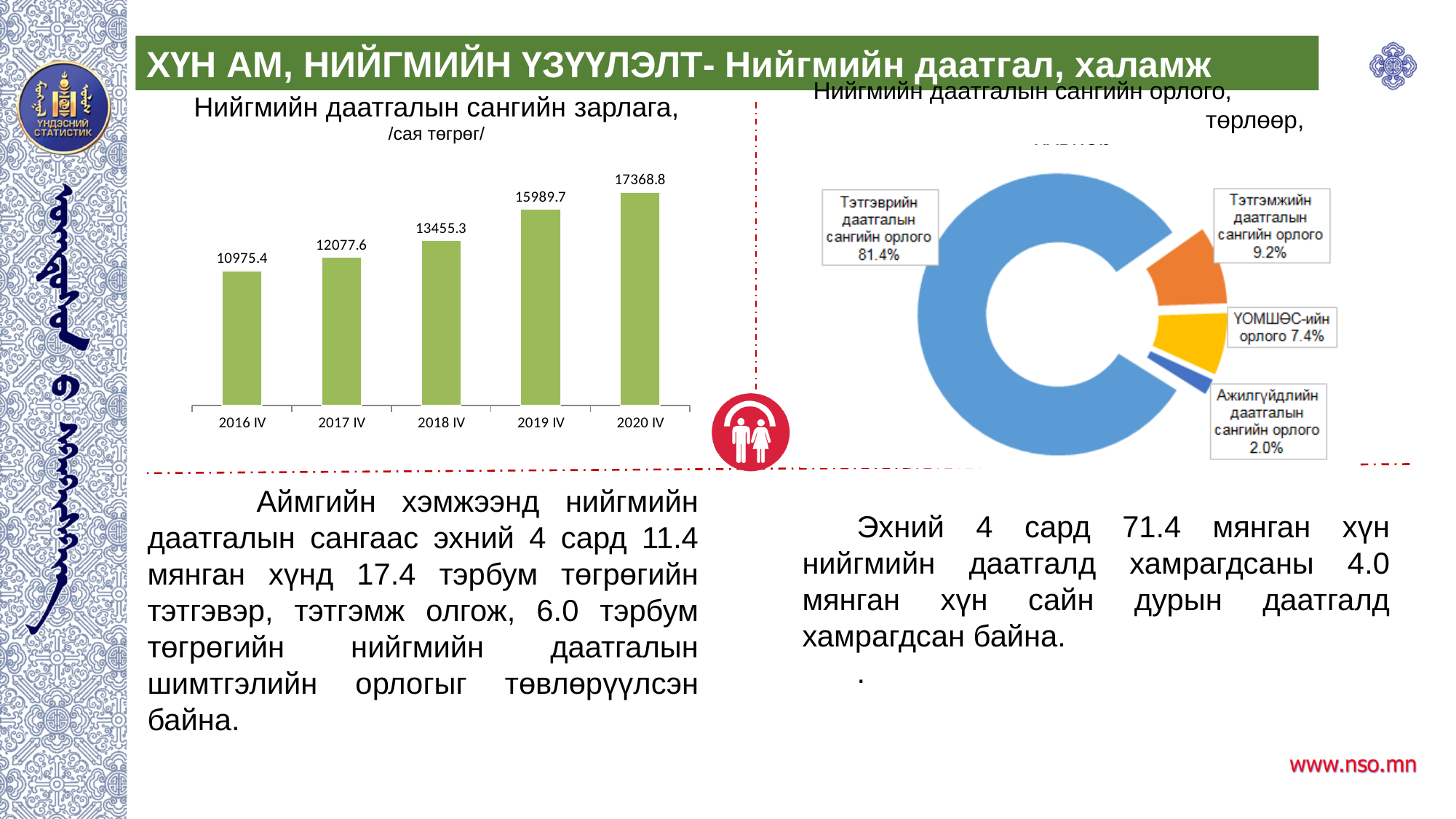
In the doughnut chart on the right, what share does 'Ажилгүйдлийн даатгалын сангийн орлого' have? 2.0% In the bar chart on the left, which period has the lowest value? 2016 IV In the bar chart on the left, what is the value for 2020 IV? 17368.8 In the bar chart on the left, what is the value for 2018 IV? 13455.3 In the bar chart on the left, do the values rise or fall from 2016 IV to 2020 IV? rise In the bar chart on the left, which period has the highest value? 2020 IV In the bar chart on the left, what is the value for 2016 IV? 10975.4 In the doughnut chart on the right, which is larger: 'Тэтгэмжийн даатгалын сангийн орлого' or 'ҮОМШӨС-ийн орлого'? Тэтгэмжийн даатгалын сангийн орлого In the doughnut chart on the right, what share does 'Тэтгэврийн даатгалын сангийн орлого' have? 81.4% What kind of chart is the chart on the left of the slide? bar chart In the bar chart on the left, how many periods are shown on the x axis? 5 In the bar chart on the left, what is the difference between the values for 2020 IV and 2019 IV? 1379.1